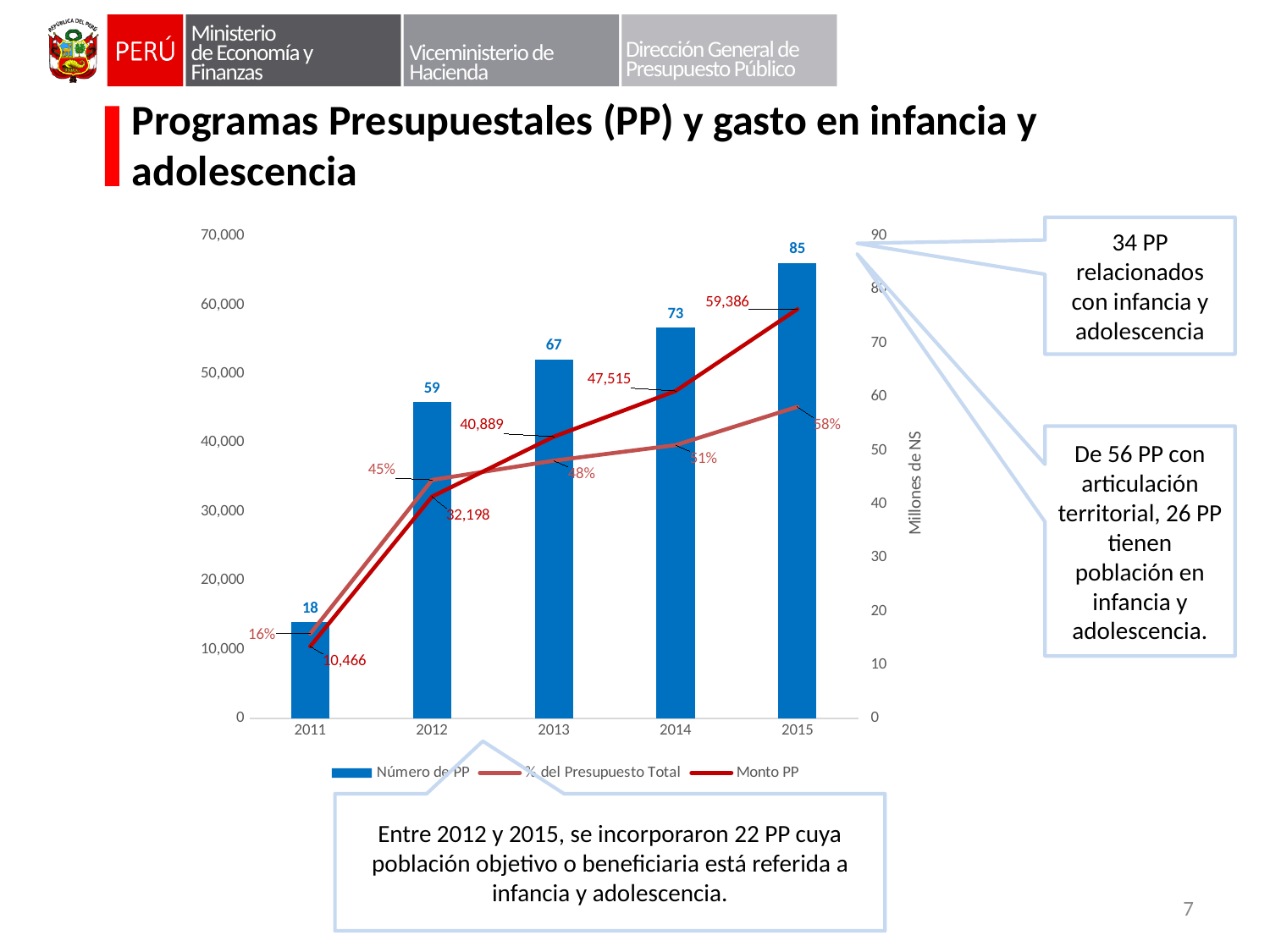
What is the difference in Número de PP between 2015 and 2011? 67 What is the label of the right-hand vertical axis? Millones de NS Which year has the highest Monto PP? 2015 Does the % del Presupuesto Total rise or fall from 2011 to 2015? rise Which year has the lowest Número de PP? 2011 What is the value of Número de PP for 2015? 85 What is the % del Presupuesto Total value for 2013? 48% What is the Monto PP value for 2012? 32,198 How many years are shown on the x axis? 5 How many series does the legend list? 3 What is the difference in Monto PP between 2015 and 2014? 11,871 Which is larger, the Número de PP in 2012 or in 2013? 2013